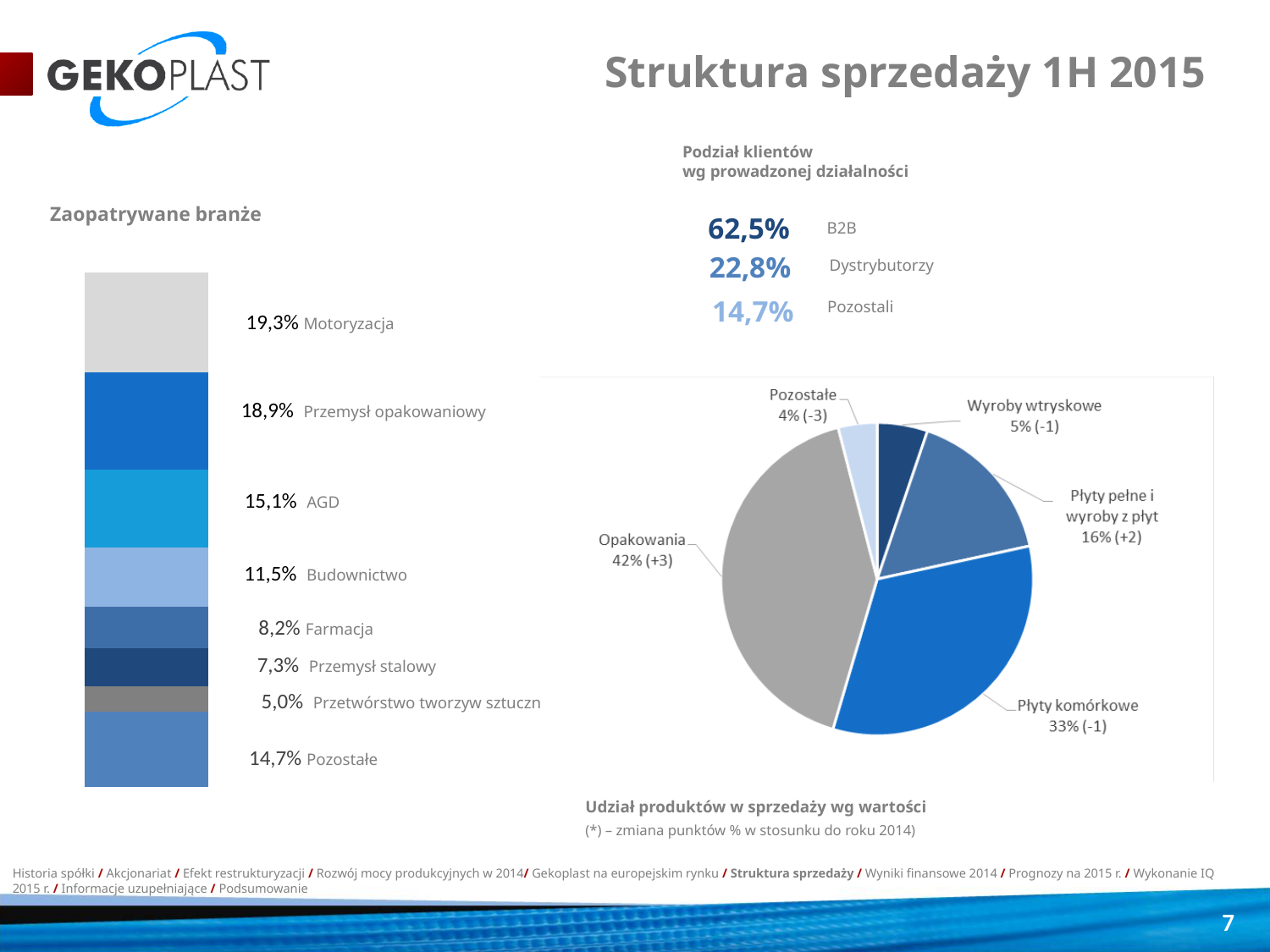
In the stacked bar chart 'Zaopatrywane branże' on the left, which industry has the smallest share? Przetwórstwo tworzyw sztucznych In the pie chart 'Udział produktów w sprzedaży wg wartości', what change in percentage points versus 2014 is shown for Opakowania? +3 In the pie chart 'Udział produktów w sprzedaży wg wartości', what share does Płyty komórkowe have? 33% In the pie chart 'Udział produktów w sprzedaży wg wartości', which product category has the largest share? Opakowania What type of chart is 'Udział produktów w sprzedaży wg wartości'? Pie chart In the pie chart 'Udział produktów w sprzedaży wg wartości', what is the difference in percentage points between Opakowania and Płyty komórkowe? 9 percentage points In the stacked bar chart 'Zaopatrywane branże' on the left, how many segments does the bar have? 8 In the pie chart 'Udział produktów w sprzedaży wg wartości', which is larger: Wyroby wtryskowe or Płyty pełne i wyroby z płyt? Płyty pełne i wyroby z płyt In the pie chart 'Udział produktów w sprzedaży wg wartości', how many slices are there? 5 In the pie chart 'Udział produktów w sprzedaży wg wartości', which product category has the smallest share? Pozostałe In the stacked bar chart 'Zaopatrywane branże' on the left, what is the value for Motoryzacja? 19,3% In the pie chart 'Udział produktów w sprzedaży wg wartości', what share does Opakowania have? 42%